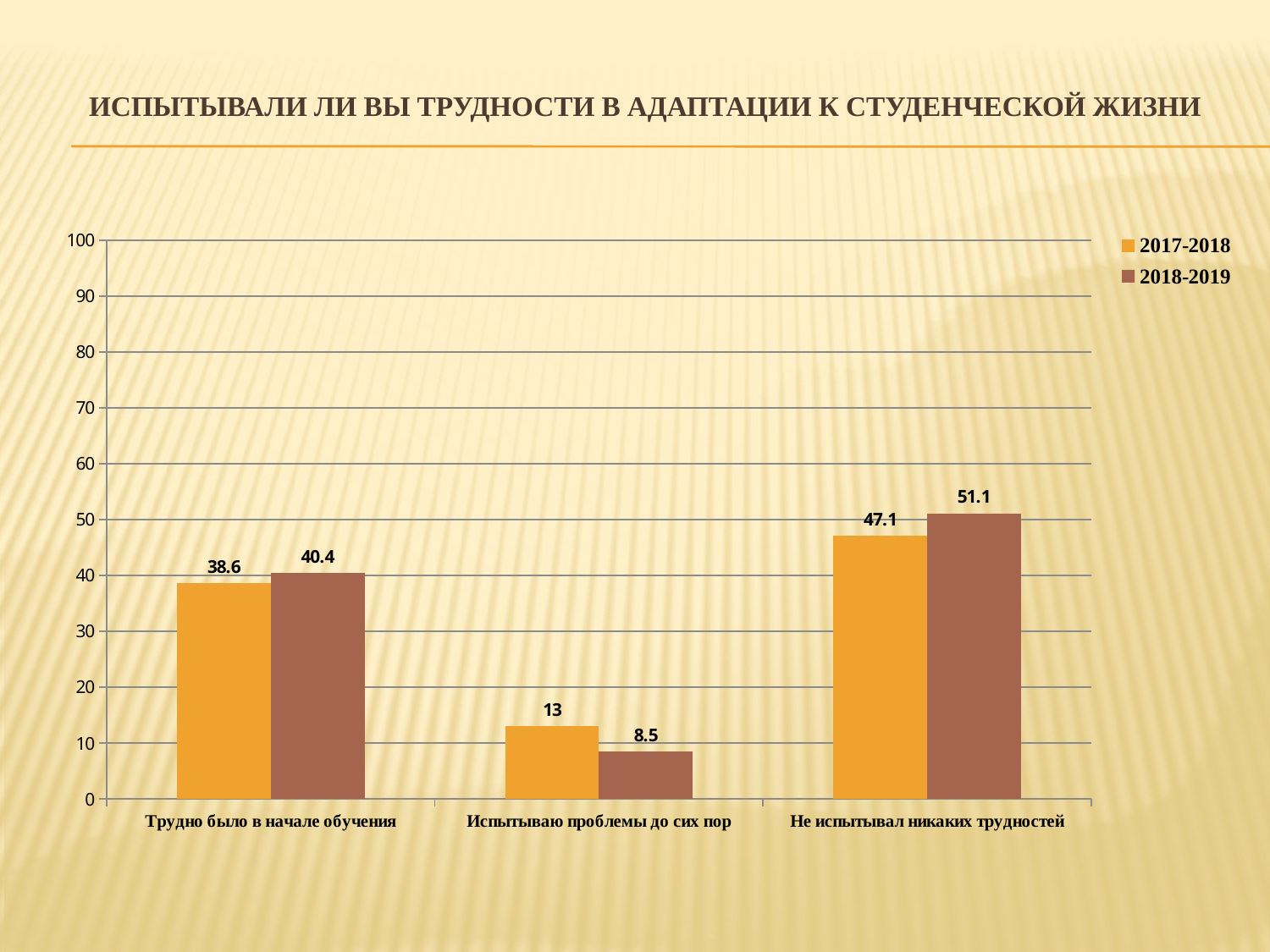
How many series does the legend list? 2 What is the value for 2018-2019 in the category "Не испытывал никаких трудностей"? 51.1 Is the 2017-2018 value for "Не испытывал никаких трудностей" greater or less than 50? less What is the difference between the 2017-2018 and 2018-2019 values for "Испытываю проблемы до сих пор"? 4.5 What is the difference between the 2018-2019 and 2017-2018 values for "Не испытывал никаких трудностей"? 4 How many categories are shown on the x axis? 3 Which category has the highest value for the 2017-2018 series? Не испытывал никаких трудностей What is the value for 2018-2019 in the category "Испытываю проблемы до сих пор"? 8.5 What kind of chart is shown on the slide? bar chart Which series has the larger value for "Трудно было в начале обучения", 2017-2018 or 2018-2019? 2018-2019 What is the value for 2017-2018 in the category "Трудно было в начале обучения"? 38.6 Which category has the lowest value for the 2018-2019 series? Испытываю проблемы до сих пор